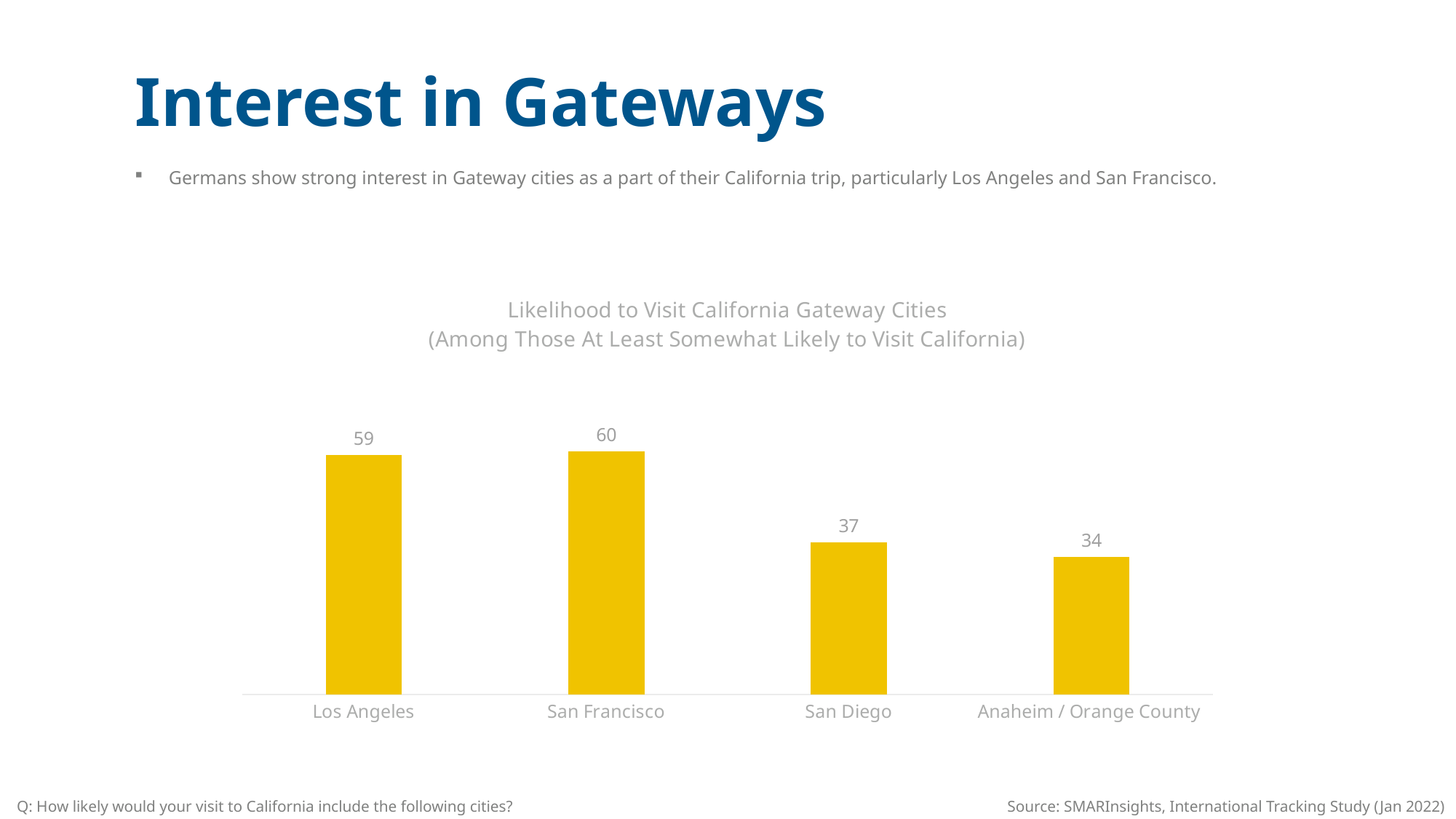
What is the value for San Diego? 37 Which is larger, the value for Los Angeles or the value for San Diego? Los Angeles What is the value for Anaheim / Orange County? 34 Which is larger, the value for San Diego or the value for Anaheim / Orange County? San Diego What is the difference between the values for San Francisco and San Diego? 23 What is the value for San Francisco? 60 What is the difference between the values for Los Angeles and Anaheim / Orange County? 25 What is the title of the chart? Likelihood to Visit California Gateway Cities (Among Those At Least Somewhat Likely to Visit California) How many cities are shown in the chart? 4 What kind of chart is shown on the slide? Bar chart What is the value for Los Angeles? 59 Which city has the lowest value? Anaheim / Orange County